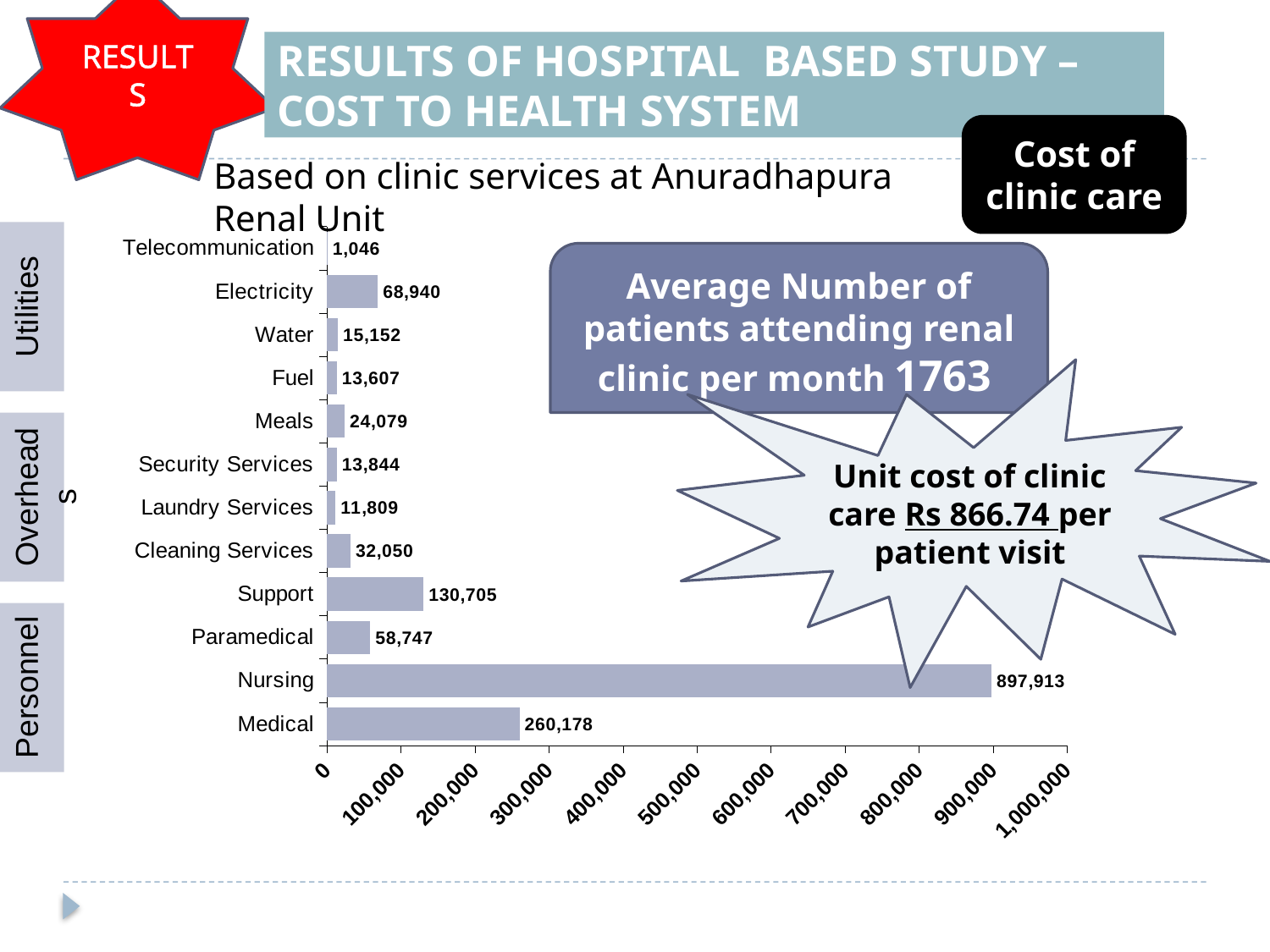
Which is larger, the value for Support or the value for Paramedical? Support What is the value for Nursing? 897,913 Is the value for Nursing greater or less than 800,000? greater What is the value for Cleaning Services? 32,050 What is the difference between the values for Medical and Support? 129,473 What kind of chart is shown on the slide? Bar chart How many categories are shown in the chart? 12 Which category has the highest value? Nursing What is the value for Electricity? 68,940 What is the difference between the values for Nursing and Medical? 637,735 Which category has the lowest value? Telecommunication